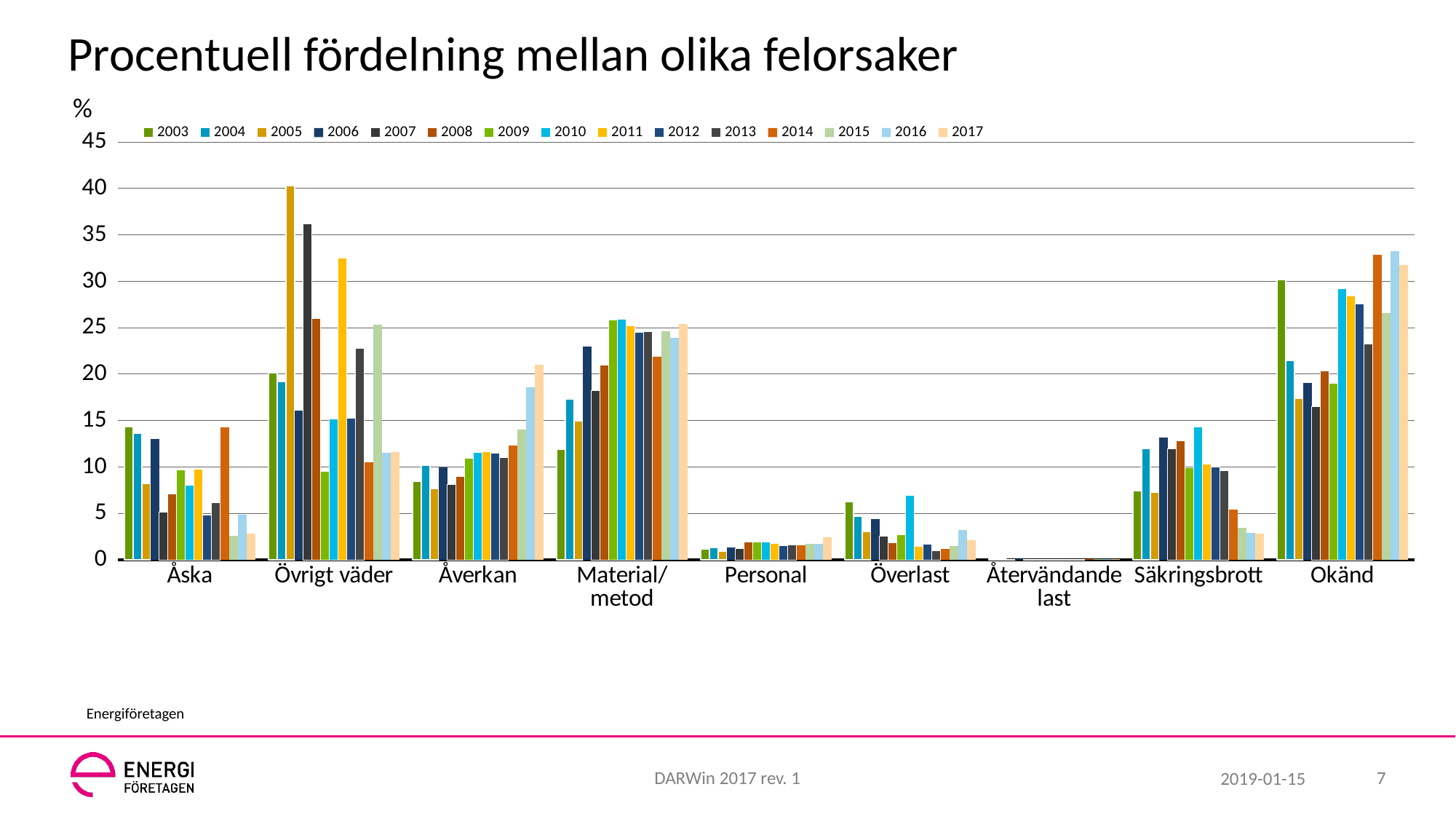
Is the value for 2010 in Överlast greater or less than 5? greater What is the title of the chart? Procentuell fördelning mellan olika felorsaker How many series does the legend list? 15 What kind of chart is shown on the slide? bar chart How many categories are shown on the x axis? 9 Which year has the highest bar in the Övrigt väder category? 2005 What unit is shown at the top of the y axis? % In the Okänd category, which is larger: the value for 2003 or the value for 2005? 2003 Is the value for 2003 in Okänd greater or less than 25? greater Is the value for 2017 in Personal greater or less than 5? less Which category has the lowest values across all years? Återvändande last